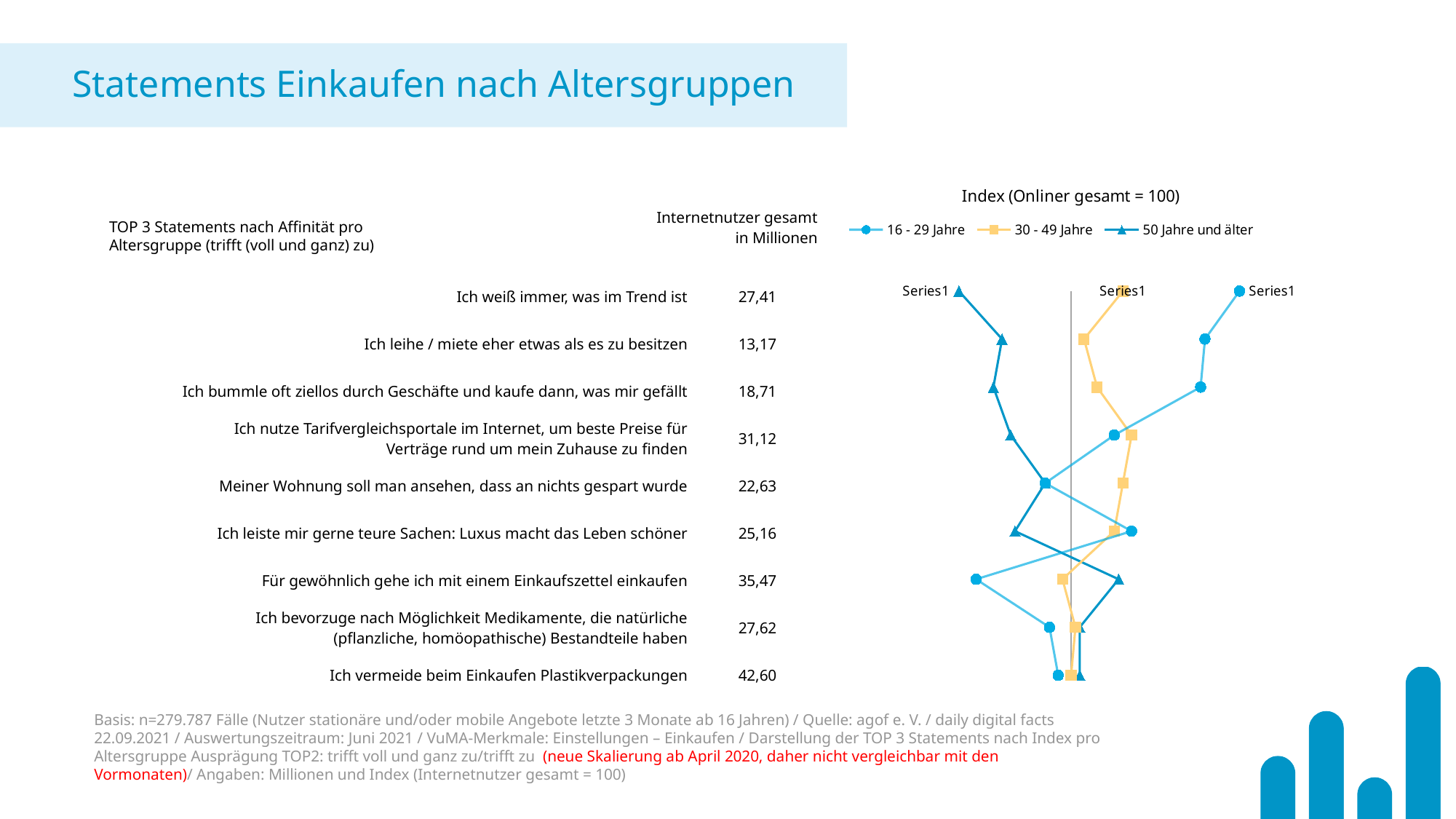
For which statement does the '16 - 29 Jahre' series reach its highest index value? Ich weiß immer, was im Trend ist What is the title shown above the chart legend? Index (Onliner gesamt = 100) What kind of chart is shown on the slide? line chart How many million internet users in total agree with 'Ich vermeide beim Einkaufen Plastikverpackungen'? 42,60 How many series does the chart legend list? 3 Which age group is represented by the yellow line with square markers? 30 - 49 Jahre For which statement does the '50 Jahre und älter' series have its lowest index value? Ich weiß immer, was im Trend ist How many statements (categories) are plotted in the chart? 9 Is the index value for '16 - 29 Jahre' on 'Ich weiß immer, was im Trend ist' greater or less than 100? greater Is the index value for '16 - 29 Jahre' on 'Für gewöhnlich gehe ich mit einem Einkaufszettel einkaufen' greater or less than 100? less Is the index value for '50 Jahre und älter' on 'Ich weiß immer, was im Trend ist' greater or less than 100? less For 'Ich leiste mir gerne teure Sachen: Luxus macht das Leben schöner', which has the higher index: '16 - 29 Jahre' or '50 Jahre und älter'? 16 - 29 Jahre